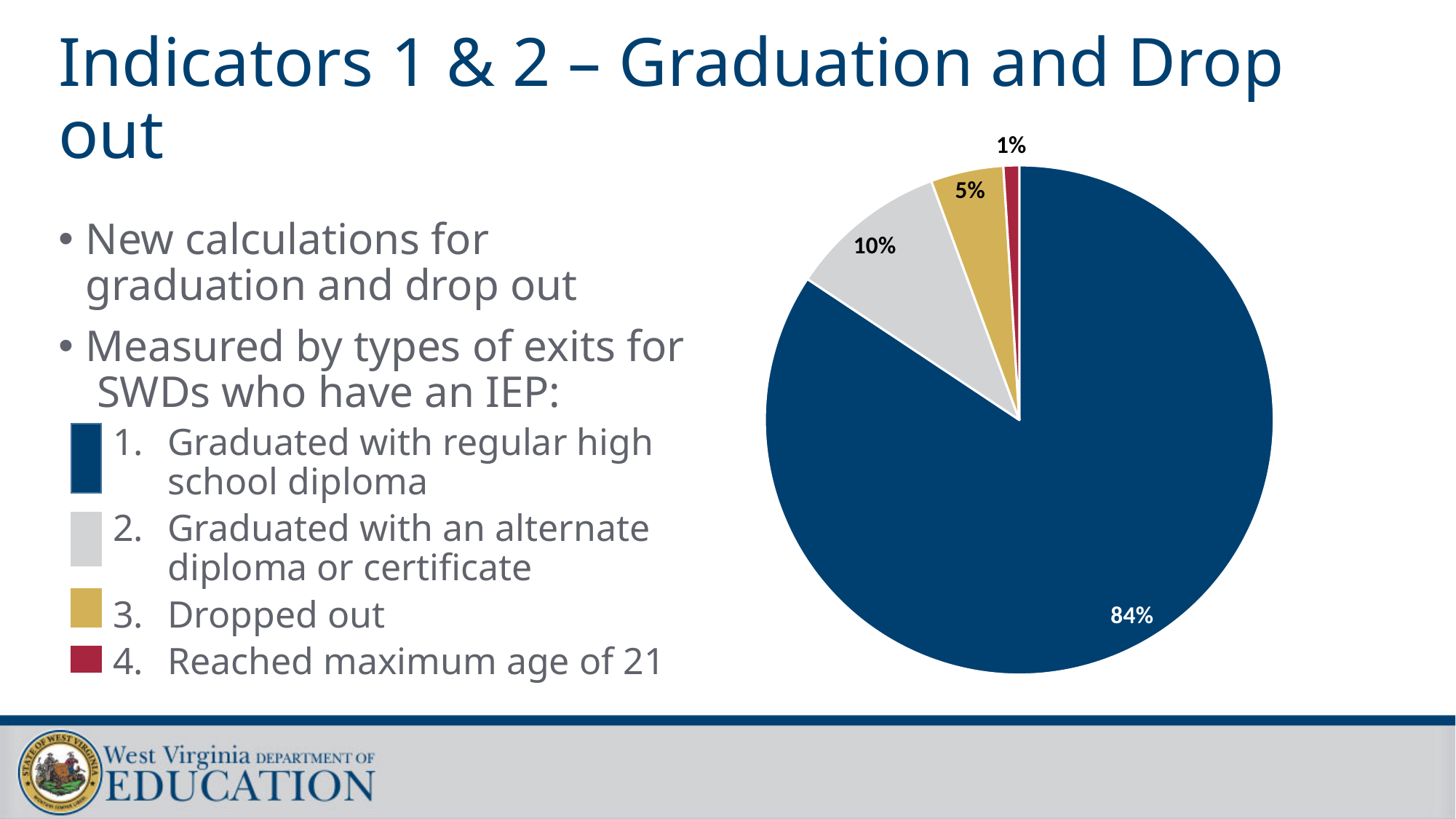
What percentage of exits were students who reached the maximum age of 21? 1% Which exit type has the largest share of the pie? Graduated with regular high school diploma Which is larger: the share for dropped out or the share for graduated with an alternate diploma or certificate? Graduated with an alternate diploma or certificate What is the difference in percentage points between graduating with a regular high school diploma and graduating with an alternate diploma or certificate? 74 What percentage of exits were students who graduated with a regular high school diploma? 84% What percentage of exits were students who dropped out? 5% Which exit type has the smallest share of the pie? Reached maximum age of 21 What type of chart is shown on the slide? pie chart How many slices does the pie chart have? 4 What percentage of exits were students who graduated with an alternate diploma or certificate? 10% What is the difference in percentage points between dropped out and reached maximum age of 21? 4 What colour is the slice representing students who dropped out? gold